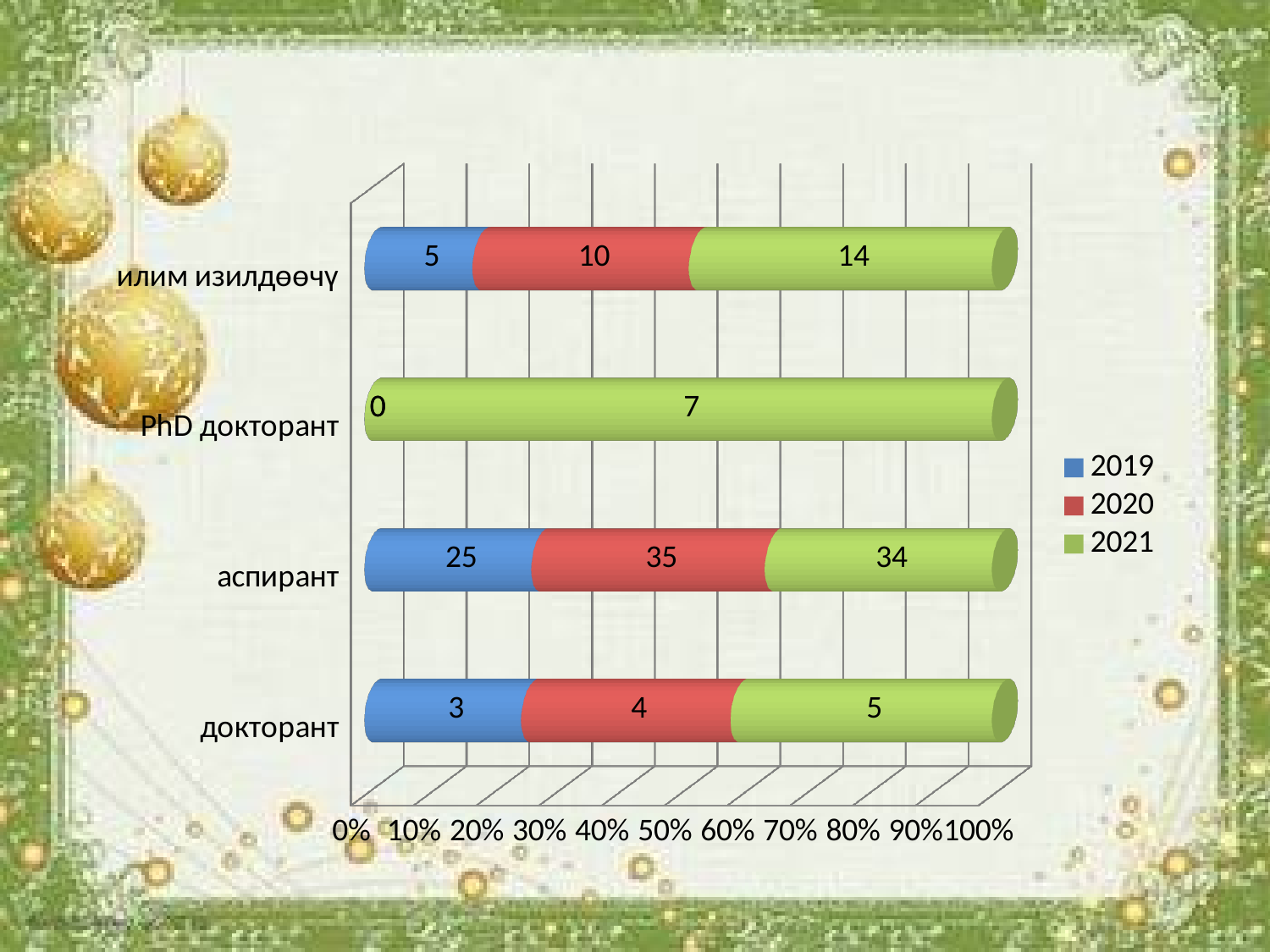
Which category has the lowest 2019 value? PhD докторант What is the 2019 value for докторант? 3 What is the difference between the 2020 and 2019 values for аспирант? 10 How many series does the legend list? 3 How many categories are shown on the chart? 4 Which is larger for илим изилдөөчү: the 2021 value or the 2019 value? 2021 What is the 2021 value for аспирант? 34 What is the total of the three values for докторант? 12 What is the 2020 value for илим изилдөөчү? 10 What kind of chart is shown on the slide? bar chart Which category has the highest 2020 value? аспирант What is the 2021 value for PhD докторант? 7